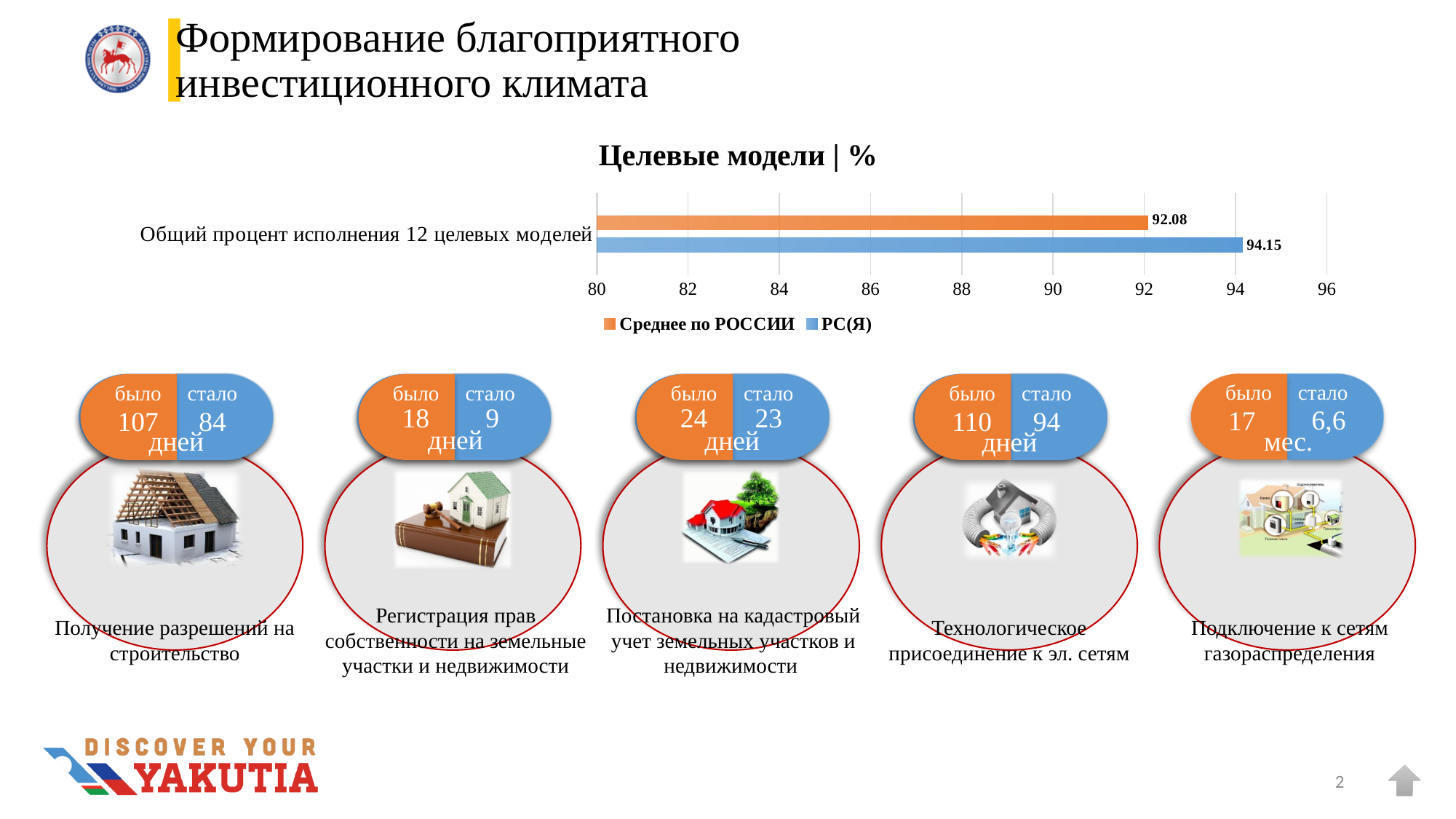
How many series does the chart legend list? 2 What is the value for РС(Я) in the chart? 94.15 What colour is the bar for РС(Я)? Blue Is the value for РС(Я) greater or less than 92? greater Is the value for Среднее по РОССИИ greater or less than 90? greater Which series has the higher value, Среднее по РОССИИ or РС(Я)? РС(Я) What is the difference between the РС(Я) value and the Среднее по РОССИИ value? 2.07 How many categories are shown on the chart's vertical axis? 1 Which series has the lowest value in the chart? Среднее по РОССИИ What kind of chart is shown on the slide? Bar chart What is the value for Среднее по РОССИИ in the chart? 92.08 What is the title of the chart? Целевые модели | %